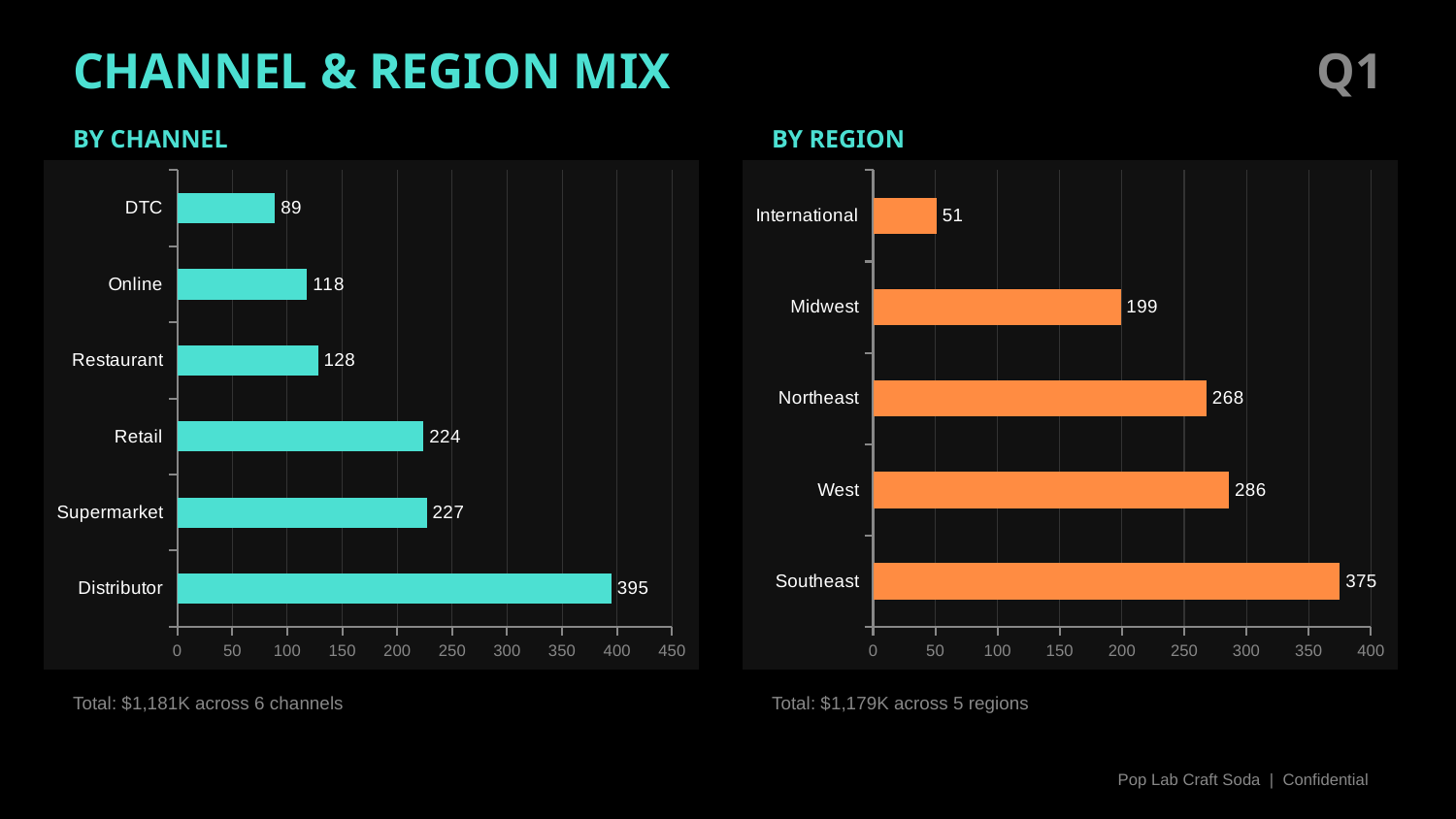
In the BY REGION chart, what is the value for Northeast? 268 In the BY CHANNEL chart, which channel has the highest value? Distributor In the BY CHANNEL chart, what is the value for Retail? 224 In the BY CHANNEL chart, what is the difference between Distributor and Supermarket? 168 In the BY REGION chart, what is the difference between Southeast and International? 324 In the BY CHANNEL chart, which channel has the lowest value? DTC What kind of chart is the BY REGION chart? Bar chart In the BY CHANNEL chart, is the value for Online greater or less than 100? greater In the BY CHANNEL chart, how many channels are shown? 6 What colour are the bars in the BY CHANNEL chart? Teal In the BY REGION chart, which is larger, West or Midwest? West In the BY REGION chart, which region has the lowest value? International